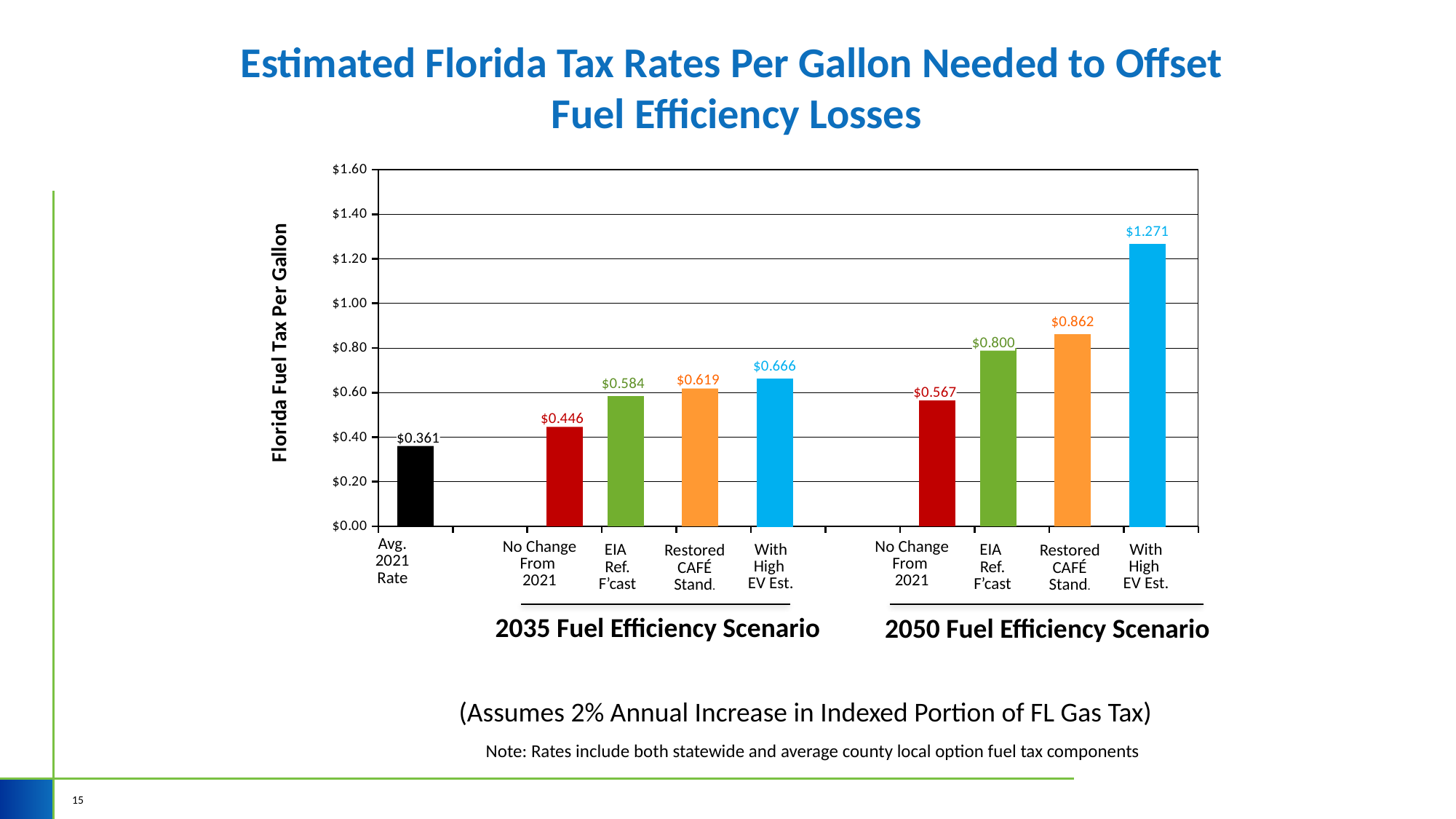
Which bar has the highest value on the chart? With High EV Est. (2050 Fuel Efficiency Scenario) What is the value for Restored CAFÉ Stand. under the 2035 Fuel Efficiency Scenario? $0.619 What is the value for With High EV Est. under the 2050 Fuel Efficiency Scenario? $1.271 How much higher is the 2035 No Change From 2021 value than the Avg. 2021 Rate? $0.085 Which is larger: Restored CAFÉ Stand. in the 2035 scenario or No Change From 2021 in the 2050 scenario? Restored CAFÉ Stand. in the 2035 scenario What kind of chart is shown on the slide? Bar chart How many bars are plotted on the chart? 9 Within the 2050 Fuel Efficiency Scenario, do the values rise or fall from left to right? Rise What is the value for EIA Ref. F'cast under the 2050 Fuel Efficiency Scenario? $0.800 What is the Florida fuel tax per gallon shown for the Avg. 2021 Rate? $0.361 Which bar has the lowest value on the chart? Avg. 2021 Rate What is the difference between the With High EV Est. values for the 2050 and 2035 scenarios? $0.605